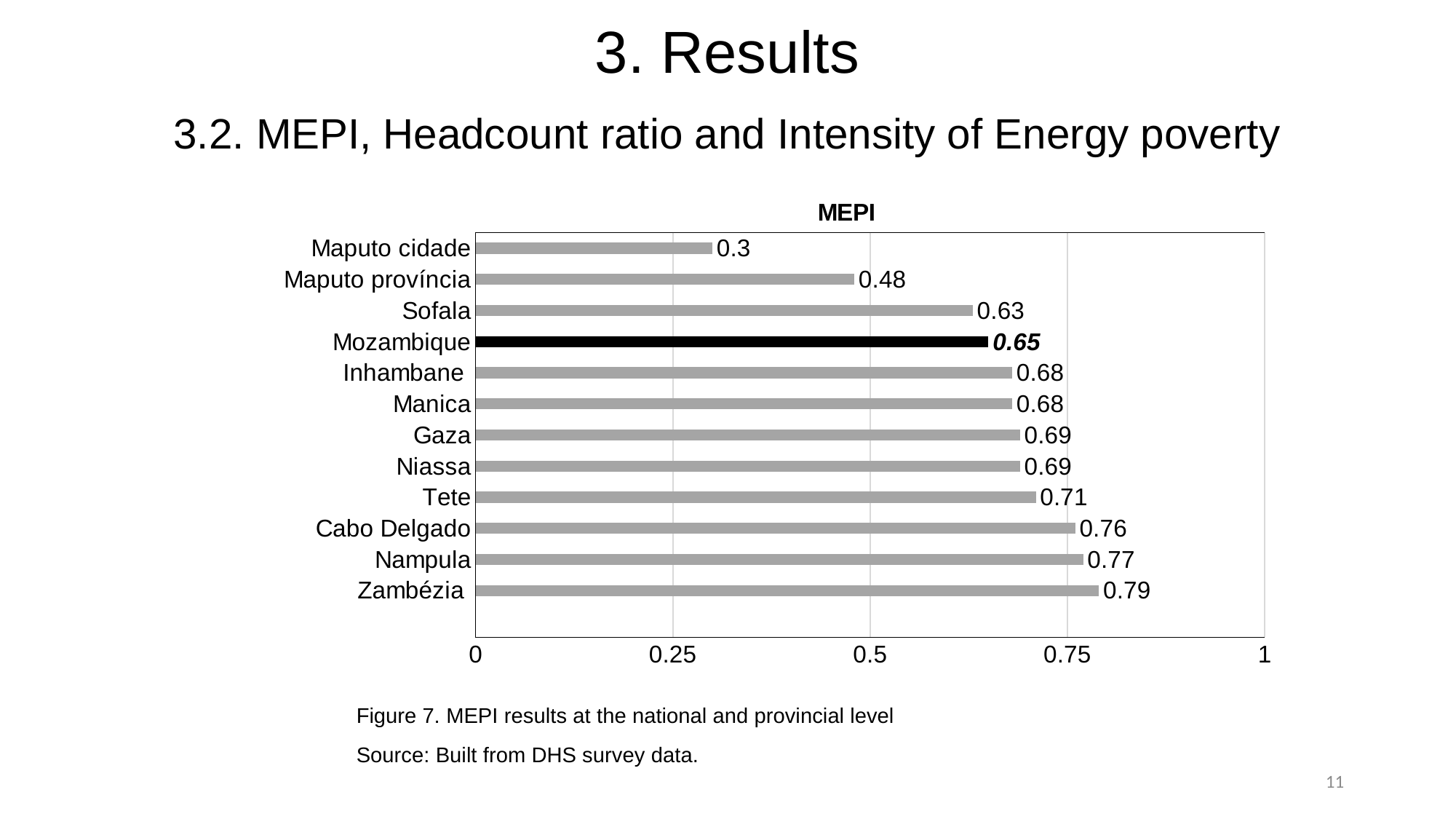
What is the MEPI value for Zambézia? 0.79 What is the MEPI value for Maputo cidade? 0.3 What kind of chart is shown on the slide? bar chart What is the difference between the MEPI values for Cabo Delgado and Sofala? 0.13 Is the MEPI value for Maputo província greater or less than 0.5? less Which category has the highest MEPI value? Zambézia Which has a higher MEPI value, Nampula or Maputo província? Nampula What is the difference between the MEPI values for Zambézia and Maputo cidade? 0.49 What is the MEPI value for Tete? 0.71 Which category has the lowest MEPI value? Maputo cidade How many categories are shown in the chart? 12 What is the MEPI value for Mozambique? 0.65